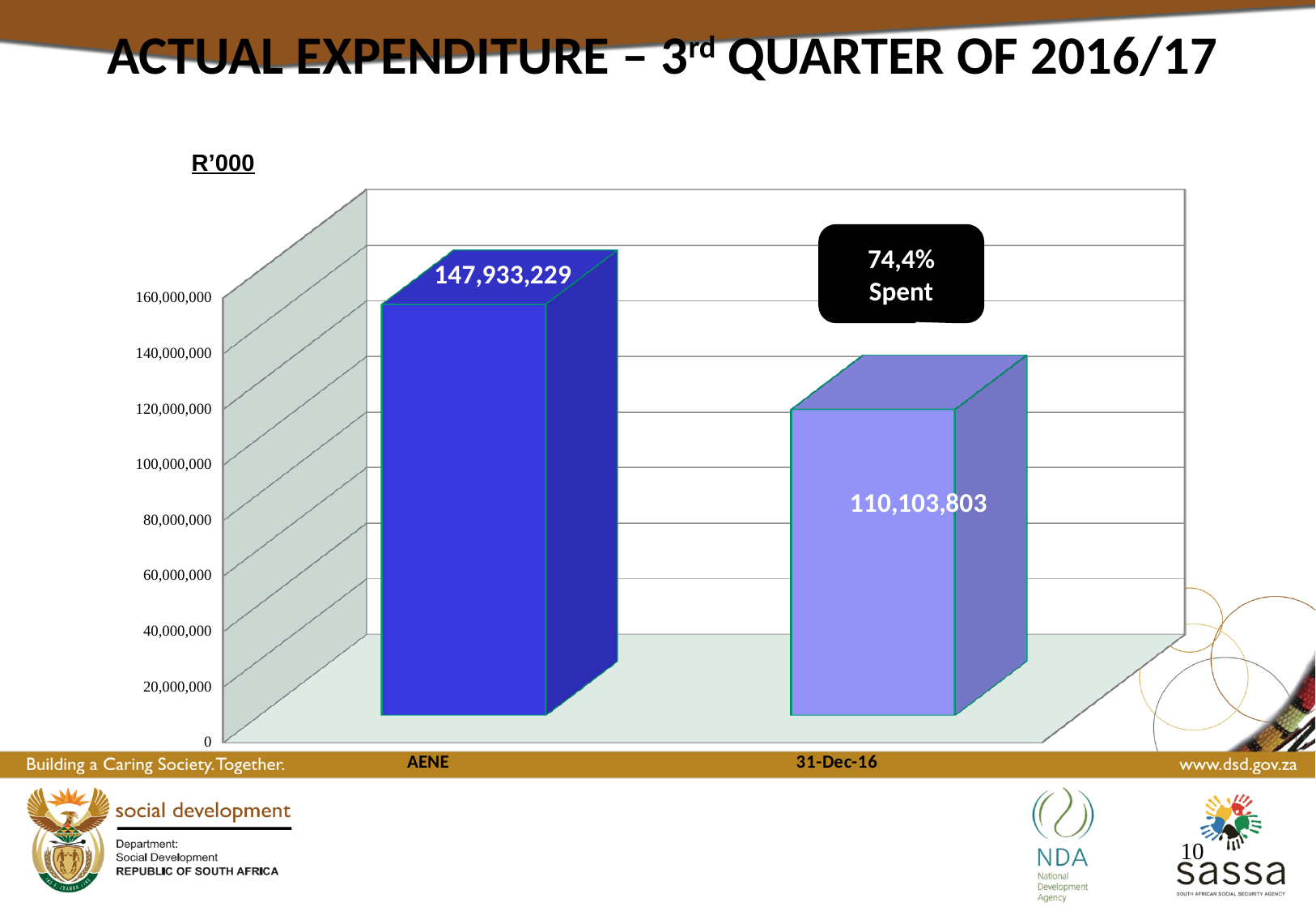
Which category has the highest value? AENE How many bars are shown in the chart? 2 What kind of chart is shown on the slide? bar chart What percentage spent is shown in the callout on the chart? 74,4% What unit label is shown above the chart? R'000 What is the value for 31-Dec-16? 110,103,803 What is the difference between the AENE value and the 31-Dec-16 value? 37,829,426 Which is larger, the value for AENE or the value for 31-Dec-16? AENE Is the value for 31-Dec-16 greater or less than 120,000,000? less Is the value for AENE greater or less than 140,000,000? greater Which category has the lowest value? 31-Dec-16 What is the value for AENE? 147,933,229